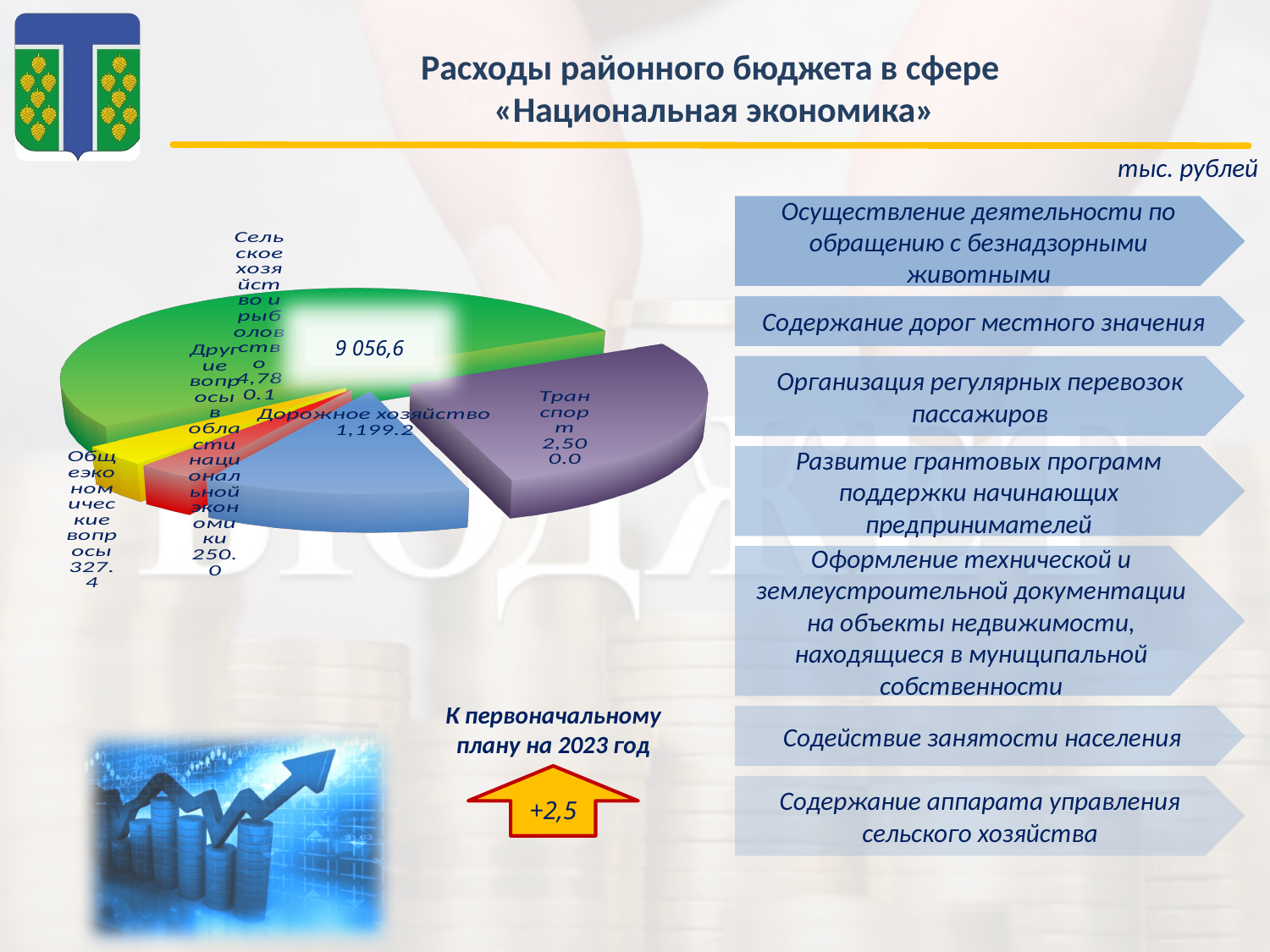
What is the value for Общеэкономические вопросы in the pie chart? 327.4 How many categories does the pie chart show? 5 What total value is printed in the box on the pie chart? 9 056,6 Which is larger in the pie chart: Транспорт or Дорожное хозяйство? Транспорт What is the difference between the values for Транспорт and Дорожное хозяйство? 1,300.8 Which category has the smallest value in the pie chart? Другие вопросы в области национальной экономики What kind of chart is shown on the slide? pie chart What is the value for Транспорт in the pie chart? 2,500.0 What is the value for Дорожное хозяйство in the pie chart? 1,199.2 Which category has the largest slice in the pie chart? Сельское хозяйство и рыболовство What is the difference between the values for Общеэкономические вопросы and Другие вопросы в области национальной экономики? 77.4 What is the value for Другие вопросы в области национальной экономики in the pie chart? 250.0